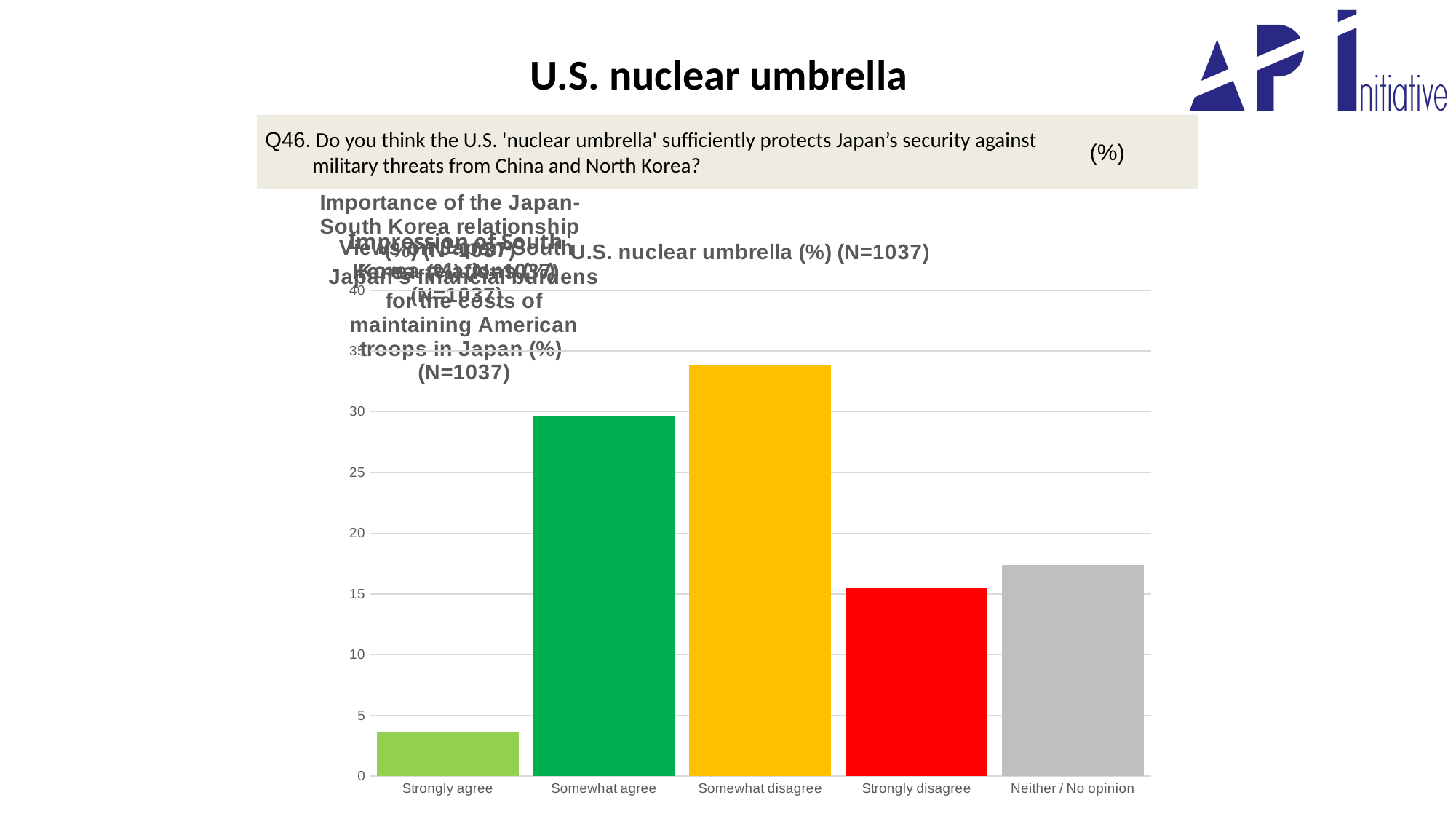
Is the value for Strongly disagree greater or less than 10? greater Is the value for Strongly agree greater or less than 5? less Which response category has the highest value in the chart? Somewhat disagree Which is larger, the value for Somewhat agree or the value for Strongly disagree? Somewhat agree What sample size (N) is given in the chart title? N=1037 Is the value for Somewhat disagree greater or less than 30? greater What kind of chart is shown on the slide? bar chart How many response categories are shown on the x axis of the chart? 5 Which is larger, the value for Somewhat agree or the value for Somewhat disagree? Somewhat disagree Which response category has the lowest value in the chart? Strongly agree